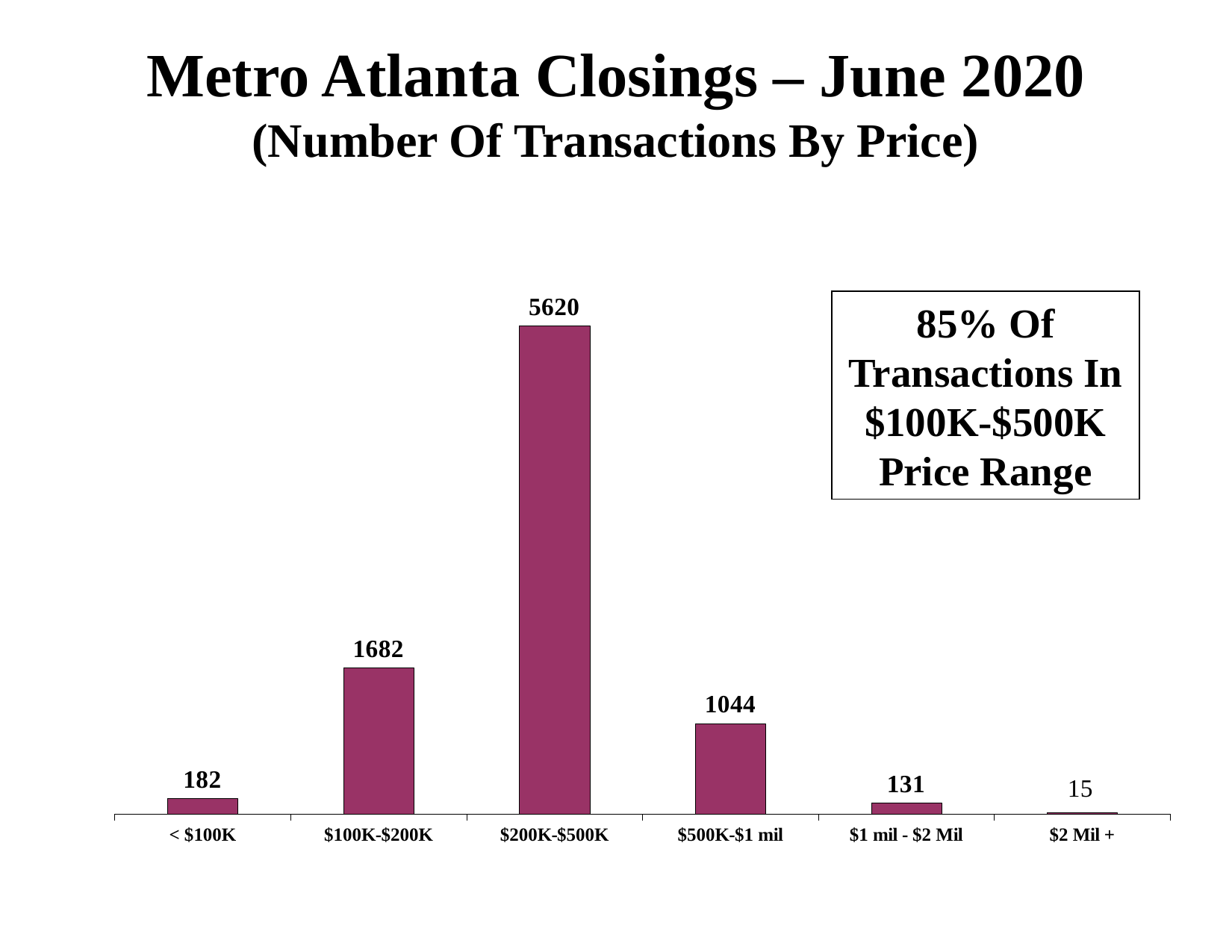
What kind of chart is shown on the slide? Bar chart Which is larger, the value for < $100K or the value for $1 mil - $2 Mil? < $100K What is the value for the < $100K category? 182 How many transactions were in the $200K-$500K price range? 5620 Which price range has the highest number of transactions? $200K-$500K What is the difference between the $200K-$500K value and the $100K-$200K value? 3938 What is the difference between the $100K-$200K and $500K-$1 mil values? 638 How many transactions were in the $1 mil - $2 Mil range? 131 What is the value for the $2 Mil + category? 15 According to the text box on the slide, what percentage of transactions are in the $100K-$500K price range? 85% Which price range has the lowest number of transactions? $2 Mil + How many price range categories are shown on the chart? 6